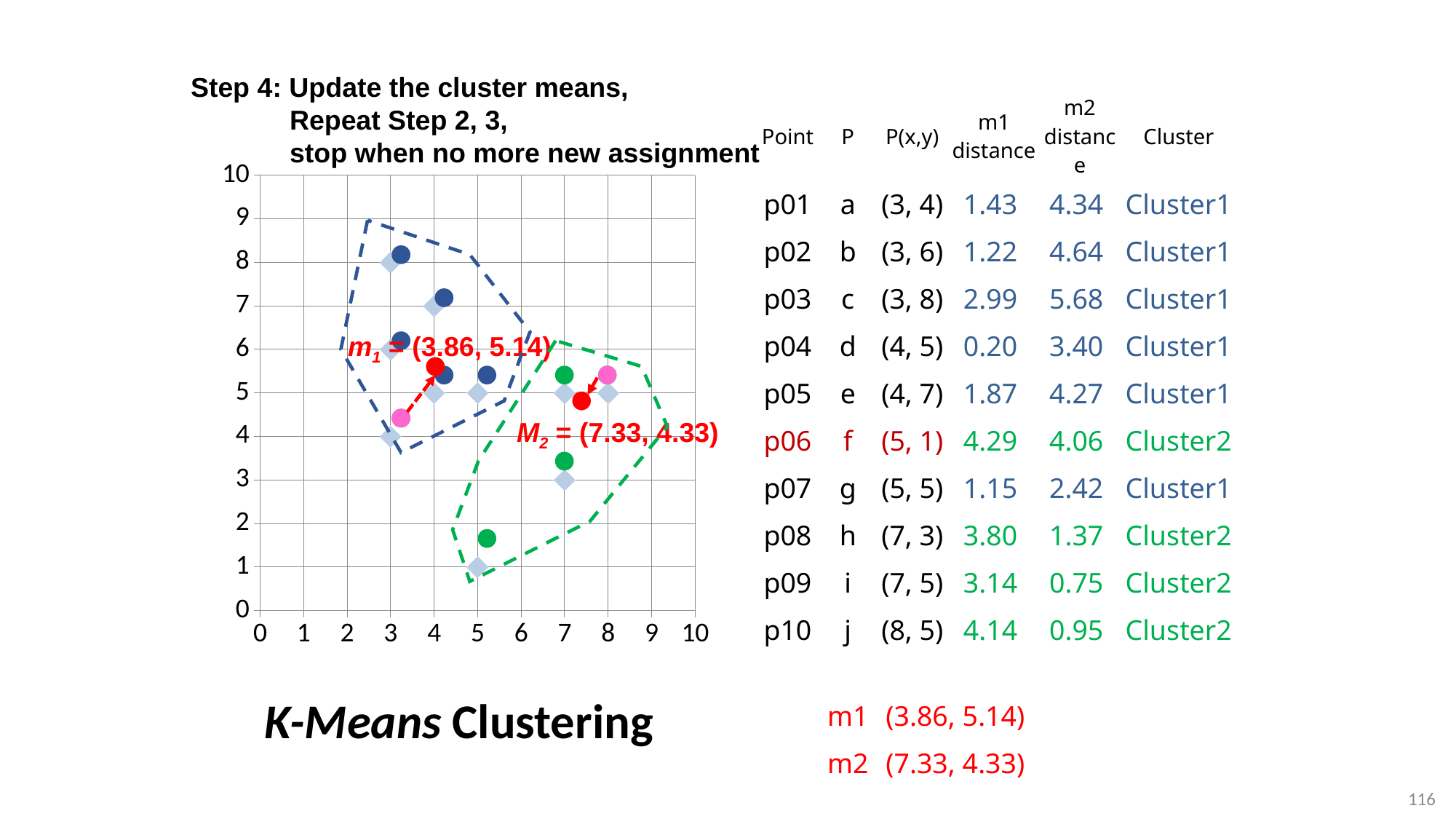
What kind of chart is shown on the left of the slide? scatter chart Which point has the lowest y value on the chart? f (5, 1) What is the maximum value shown on the x axis of the chart? 10 What are the coordinates of the cluster mean M2 labelled on the chart? (7.33, 4.33) Which point has the highest y value on the chart? c (3, 8) How many clusters are outlined with dashed lines on the chart? 2 What are the coordinates of the cluster mean m1 labelled on the chart? (3.86, 5.14) Is the x coordinate of cluster mean M2 greater or less than 7? greater Is the y coordinate of cluster mean m1 greater or less than 5? greater What colour is the dashed outline around Cluster2 on the chart? green How many data points (p01 to p10) are plotted on the chart? 10 Which cluster mean has the larger x coordinate, m1 or M2? M2